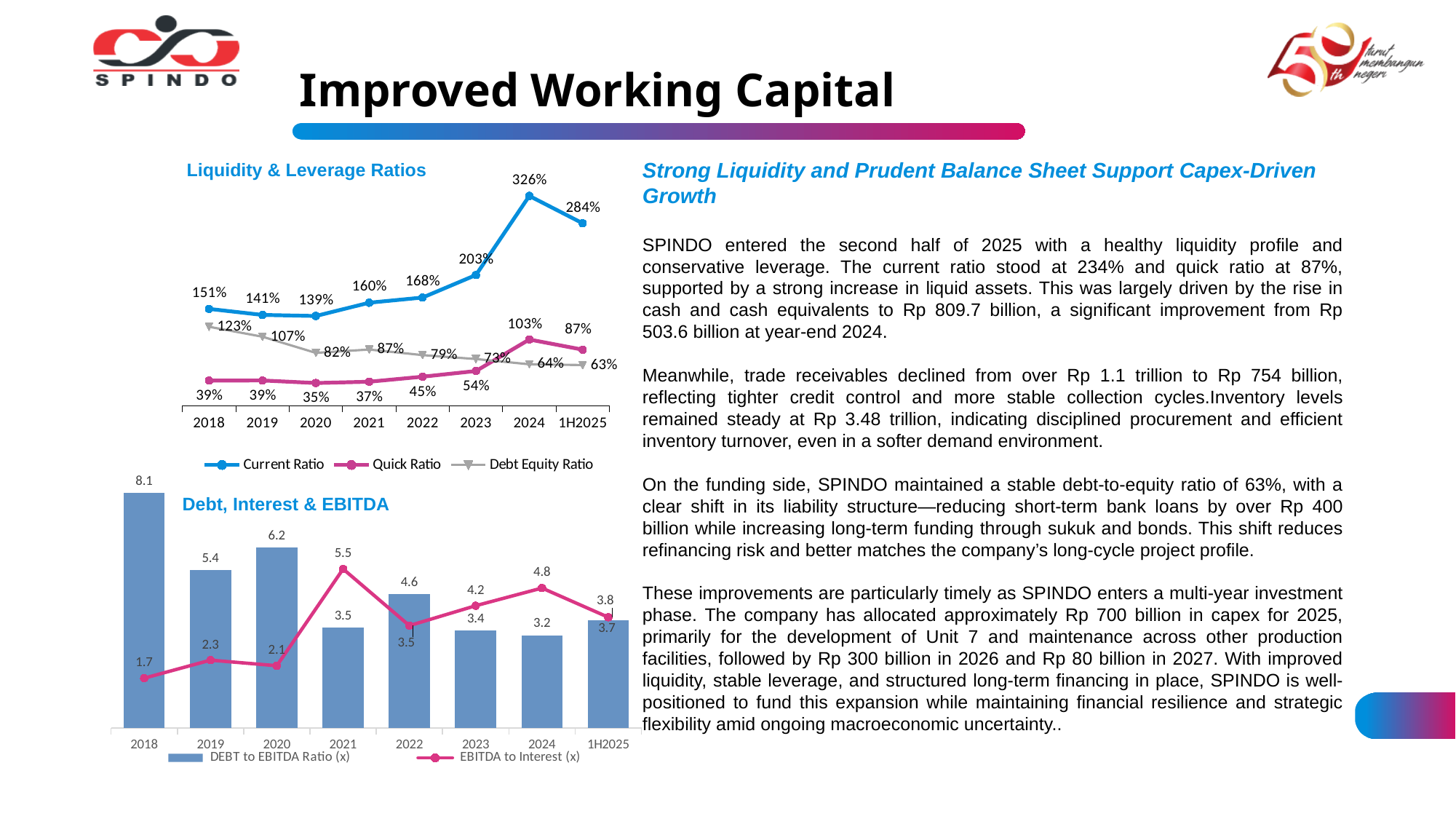
In the Liquidity & Leverage Ratios chart, what is the Debt Equity Ratio for 2018? 123% How many categories are shown on the x axis of the Debt, Interest & EBITDA chart? 8 How many series does the legend of the Liquidity & Leverage Ratios chart list? 3 In the Debt, Interest & EBITDA chart, what is the DEBT to EBITDA Ratio for 2018? 8.1 In the Liquidity & Leverage Ratios chart, does the Debt Equity Ratio rise or fall from 2018 to 1H2025? fall In the Liquidity & Leverage Ratios chart, which year has the lowest Quick Ratio? 2020 In the Debt, Interest & EBITDA chart, which is larger in 2022: the DEBT to EBITDA Ratio or the EBITDA to Interest value? DEBT to EBITDA Ratio In the Liquidity & Leverage Ratios chart, what is the difference between the Current Ratio in 2024 and in 1H2025? 42% In the Liquidity & Leverage Ratios chart, what is the Quick Ratio for 1H2025? 87% In the Debt, Interest & EBITDA chart, which year has the highest EBITDA to Interest value? 2021 In the Liquidity & Leverage Ratios chart, what is the Current Ratio for 2024? 326% In the Debt, Interest & EBITDA chart, what is the EBITDA to Interest value for 2021? 5.5